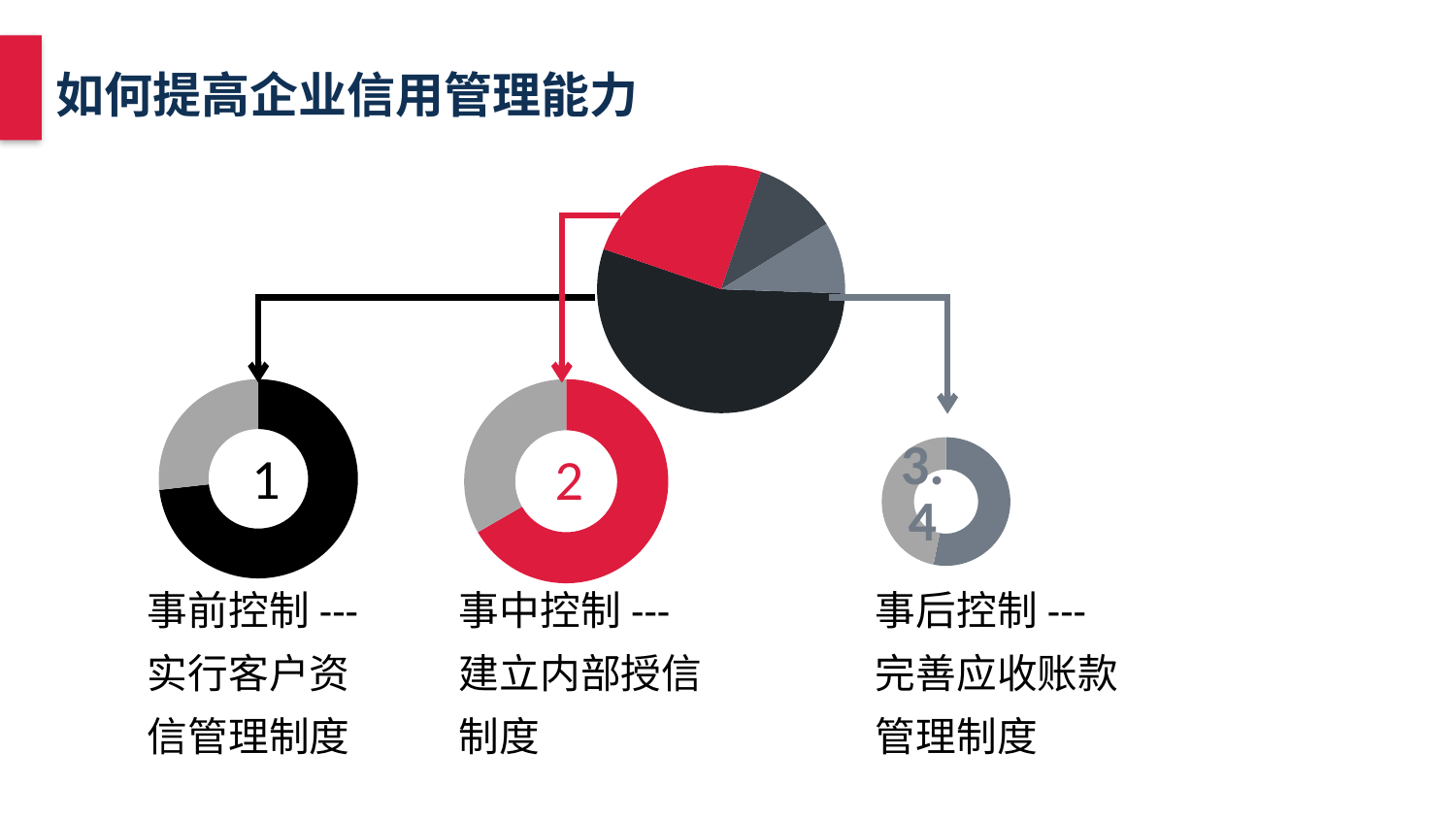
How many slices does the pie chart at the top of the slide have? 4 What kind of chart is the chart labelled 1 on the left of the slide? donut chart In the pie chart at the top of the slide, which is larger, the black slice or the red slice? black What number is printed in the centre of the middle donut chart? 2 What is the title of the slide containing the pie chart? 如何提高企业信用管理能力 In the pie chart at the top of the slide, which colour slice is the largest? black How many donut charts are shown below the pie chart on the slide? 3 In the donut chart labelled 2, which is larger, the red portion or the gray portion? red In the donut chart labelled 1, which is larger, the black portion or the gray portion? black What kind of chart is the large chart at the top centre of the slide? pie chart